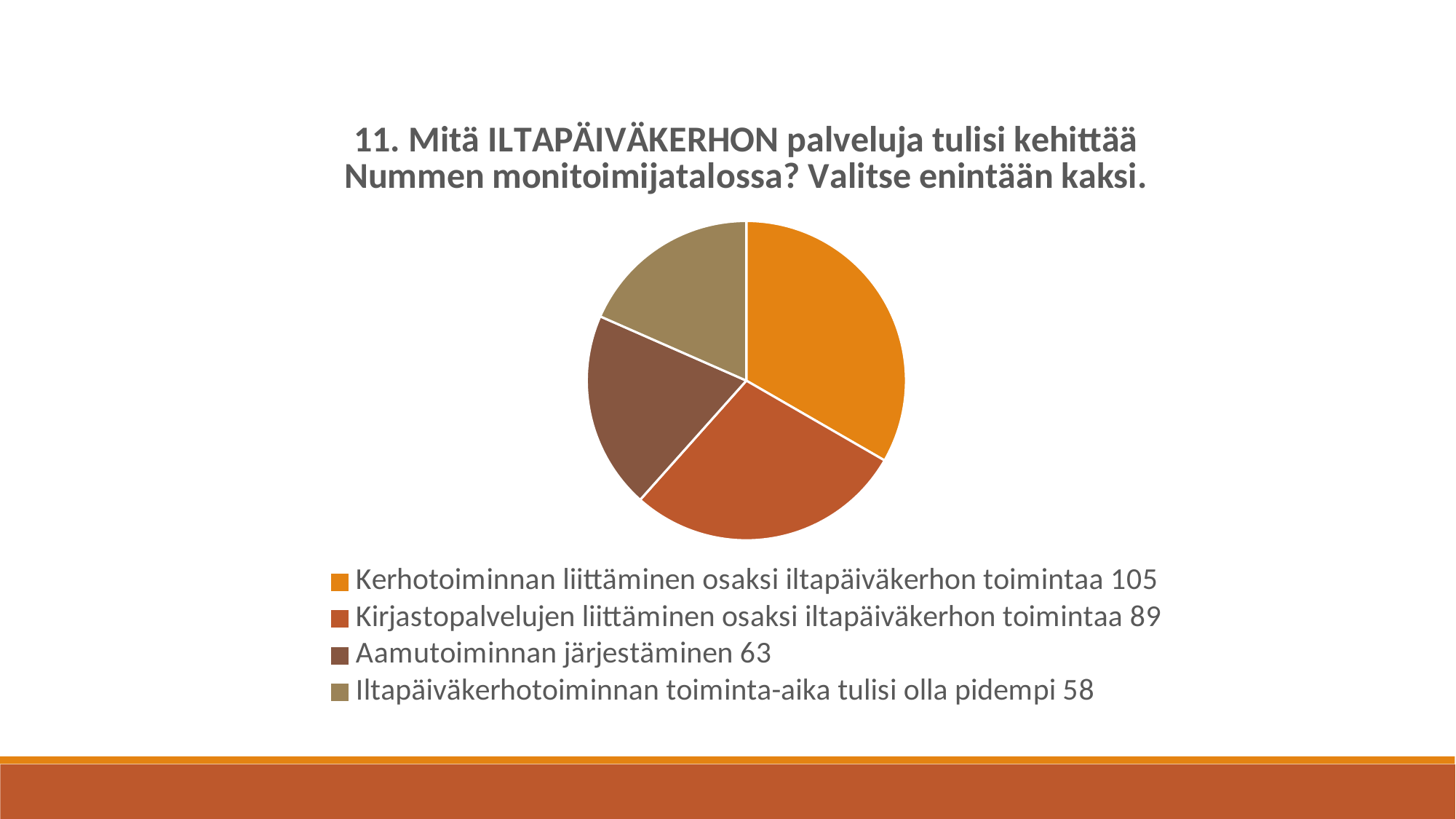
Which category has the smallest slice of the pie? Iltapäiväkerhotoiminnan toiminta-aika tulisi olla pidempi What is the value for "Iltapäiväkerhotoiminnan toiminta-aika tulisi olla pidempi"? 58 Which is larger: the value for "Aamutoiminnan järjestäminen" or the value for "Iltapäiväkerhotoiminnan toiminta-aika tulisi olla pidempi"? Aamutoiminnan järjestäminen What is the value for "Aamutoiminnan järjestäminen"? 63 What is the value for "Kirjastopalvelujen liittäminen osaksi iltapäiväkerhon toimintaa"? 89 What share of the pie does "Aamutoiminnan järjestäminen" represent? 20% Which category has the largest slice of the pie? Kerhotoiminnan liittäminen osaksi iltapäiväkerhon toimintaa What is the value for "Kerhotoiminnan liittäminen osaksi iltapäiväkerhon toimintaa"? 105 How many slices does the pie chart have? 4 What kind of chart is shown on the slide? pie chart What colour is the slice for "Kerhotoiminnan liittäminen osaksi iltapäiväkerhon toimintaa"? orange What is the difference between the values for "Kerhotoiminnan liittäminen osaksi iltapäiväkerhon toimintaa" and "Kirjastopalvelujen liittäminen osaksi iltapäiväkerhon toimintaa"? 16